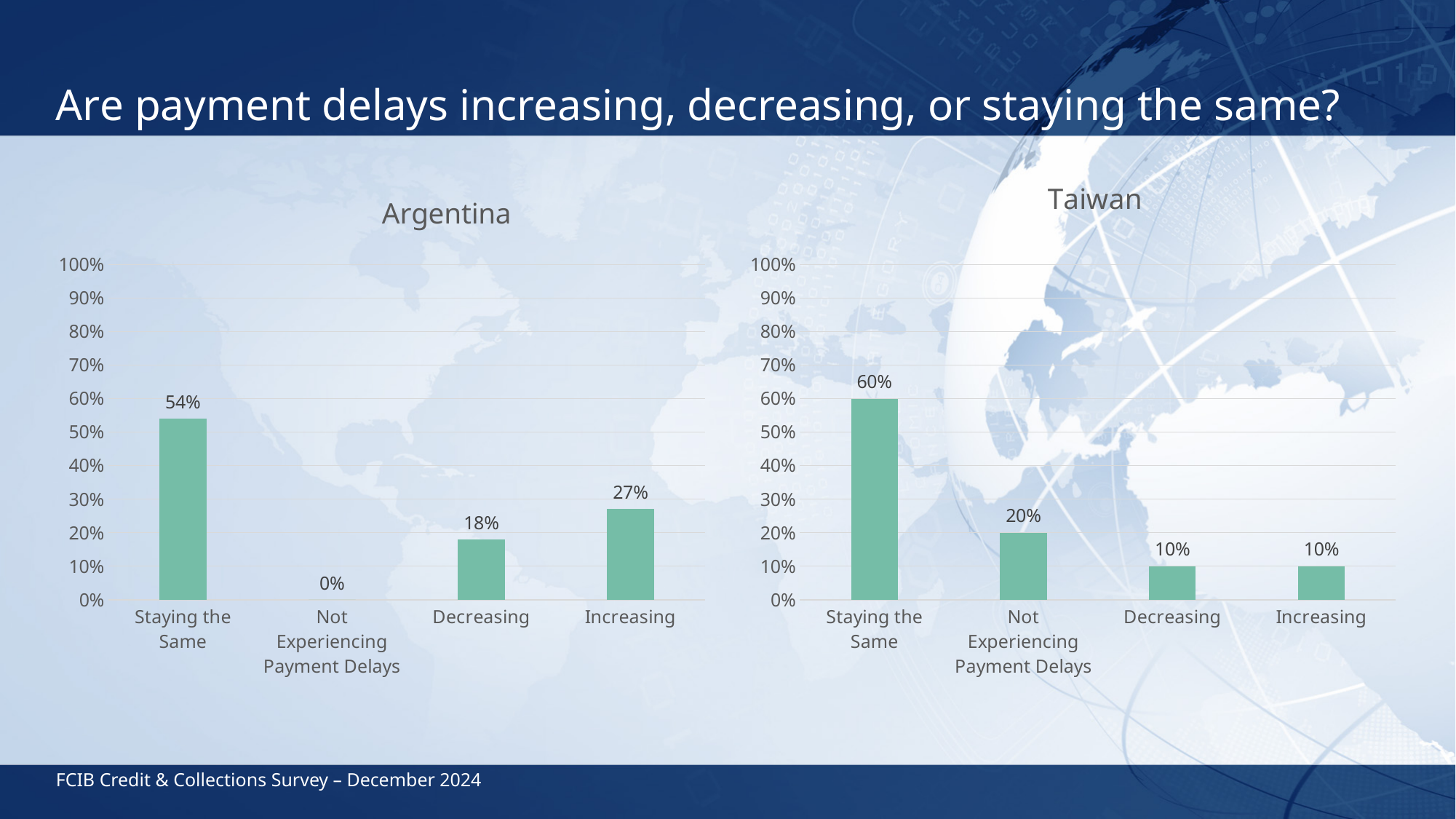
In the Argentina chart, which category has the lowest value? Not Experiencing Payment Delays In the Argentina chart, what is the value for Increasing? 27% What is the title of the chart on the right side of the slide? Taiwan In the Argentina chart, what is the difference between Increasing and Decreasing? 9% In the Taiwan chart, which category has the highest value? Staying the Same In the Taiwan chart, what is the value for Not Experiencing Payment Delays? 20% In the Taiwan chart, is the value for Staying the Same greater or less than 50%? greater In the Argentina chart, which is larger, Decreasing or Increasing? Increasing In the Argentina chart, what is the value for Staying the Same? 54% In the Taiwan chart, what is the difference between Staying the Same and Not Experiencing Payment Delays? 40% What kind of chart is the Taiwan chart? Bar chart How many categories are shown in the Argentina chart? 4